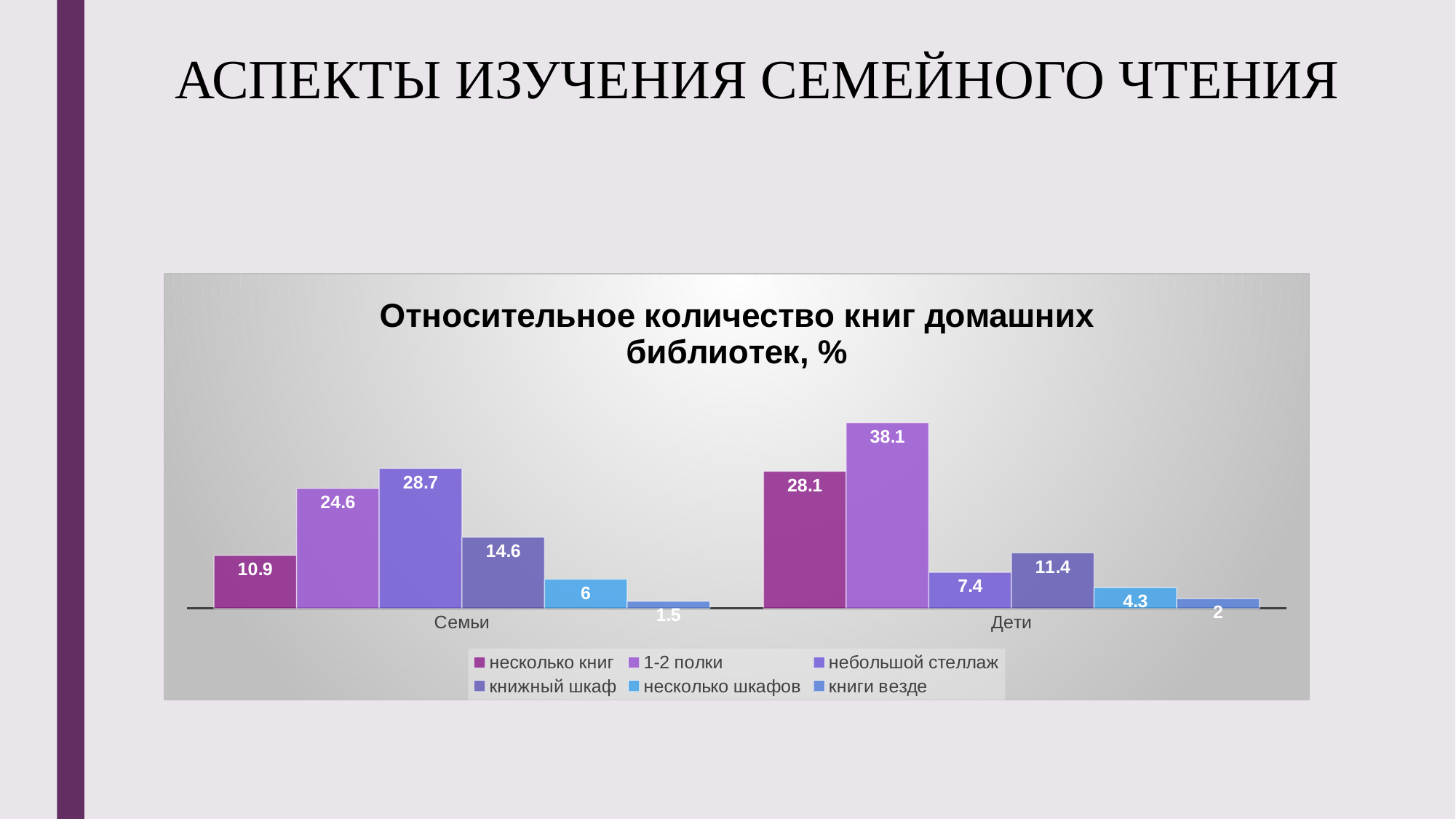
What is the difference between the 'несколько книг' values for 'Дети' and 'Семьи'? 17.2 What is the value for '1-2 полки' in the 'Дети' category? 38.1 What is the value for 'небольшой стеллаж' in the 'Семьи' category? 28.7 What type of chart is shown on the slide? bar chart How many series does the legend list? 6 How many categories are shown on the x axis? 2 Which series has the lowest value in the 'Семьи' category? книги везде What is the value for 'несколько шкафов' in the 'Дети' category? 4.3 Which series has the highest value in the 'Дети' category? 1-2 полки Which is larger: 'книжный шкаф' for 'Семьи' or 'книжный шкаф' for 'Дети'? Семьи What is the title of the chart? Относительное количество книг домашних библиотек, % What is the value for 'книги везде' in the 'Семьи' category? 1.5